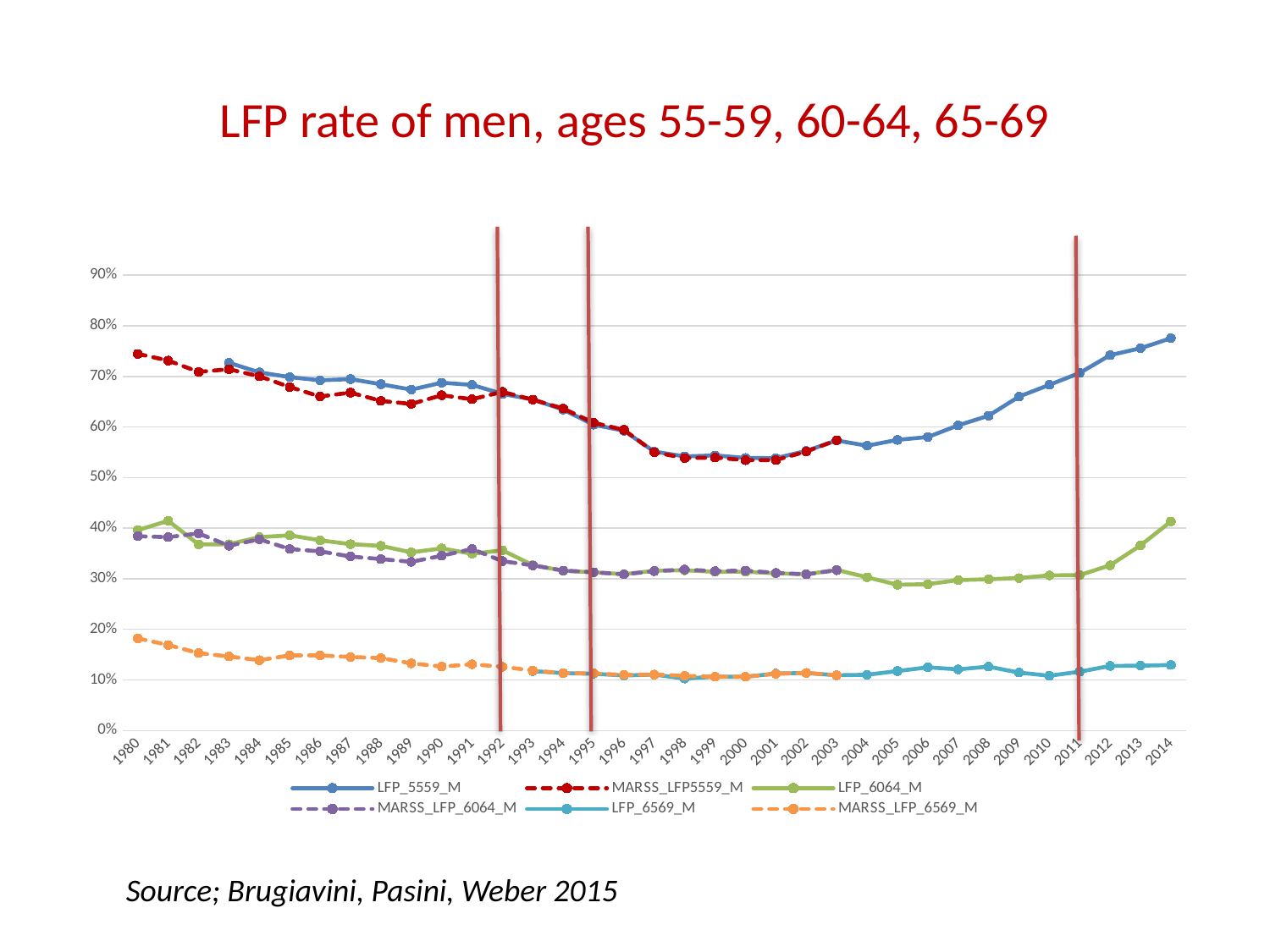
How many years are plotted along the x axis? 35 Does the MARSS_LFP_6569_M series rise or fall between 1980 and 2003? fall How many series does the legend list? 6 Is the value for MARSS_LFP5559_M in 1980 greater or less than 70%? greater What is the title of the chart? LFP rate of men, ages 55-59, 60-64, 65-69 What kind of chart is shown on the slide? line chart Is the value for LFP_6569_M in 2014 greater or less than 20%? less Is the value for LFP_5559_M in 2014 greater or less than 70%? greater Does the LFP_5559_M series rise or fall between 2004 and 2014? rise Which series has the highest value in 2014? LFP_5559_M Which series has the lowest value in 1980? MARSS_LFP_6569_M